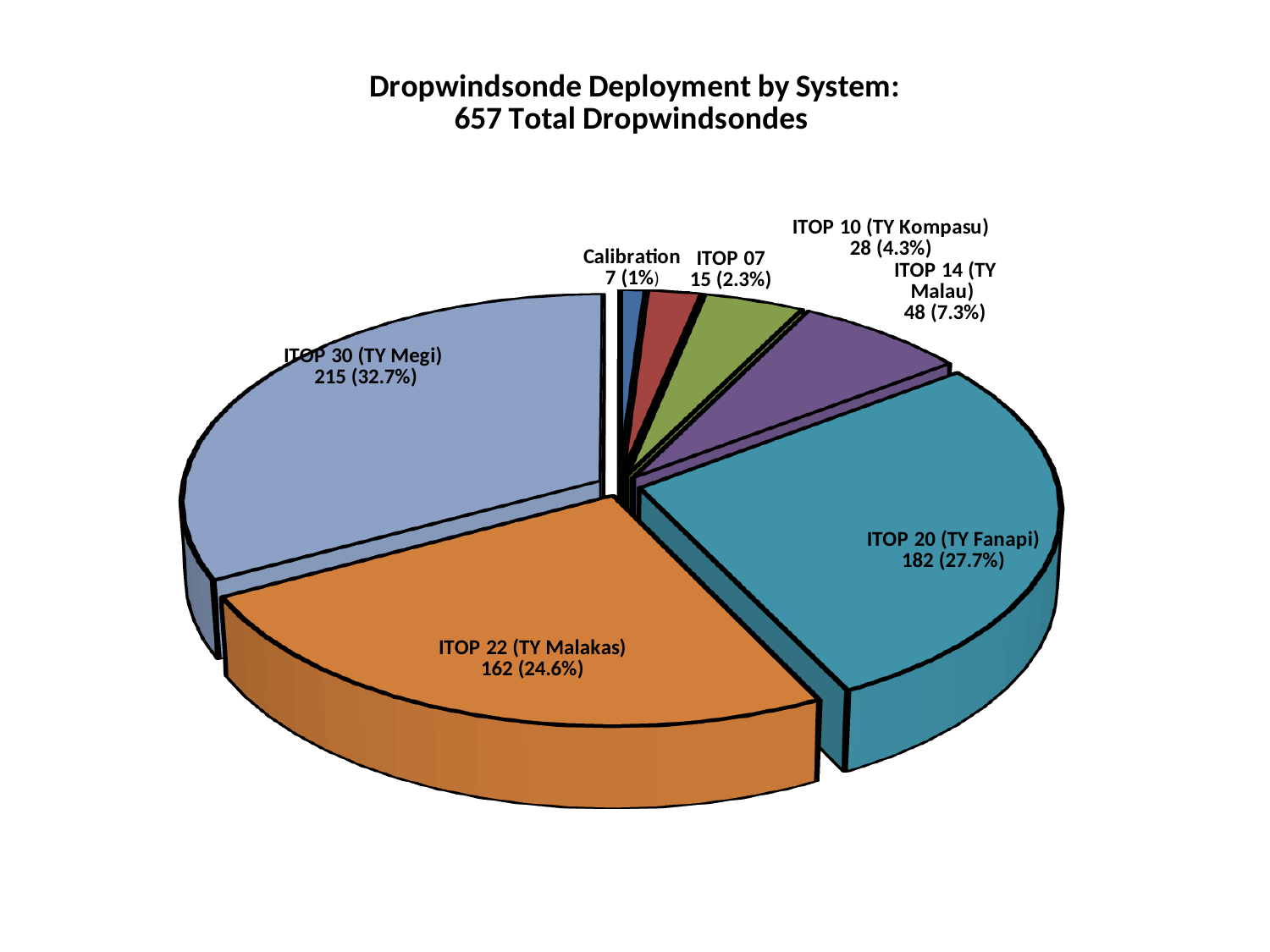
How many dropwindsondes were deployed for ITOP 14 (TY Malau)? 48 Which category has the smallest slice of the pie? Calibration How many slices does the pie chart have? 7 What share of the pie does ITOP 22 (TY Malakas) represent? 24.6% What is the total number of dropwindsondes shown in the chart title? 657 Which system has the largest slice of the pie? ITOP 30 (TY Megi) What percentage share does ITOP 10 (TY Kompasu) have? 4.3% What is the difference in dropwindsondes between ITOP 30 (TY Megi) and ITOP 20 (TY Fanapi)? 33 Which has more dropwindsondes, ITOP 10 (TY Kompasu) or ITOP 07? ITOP 10 (TY Kompasu) What is the title of the chart? Dropwindsonde Deployment by System: 657 Total Dropwindsondes What kind of chart is shown on the slide? Pie chart How many dropwindsondes were deployed for ITOP 20 (TY Fanapi)? 182